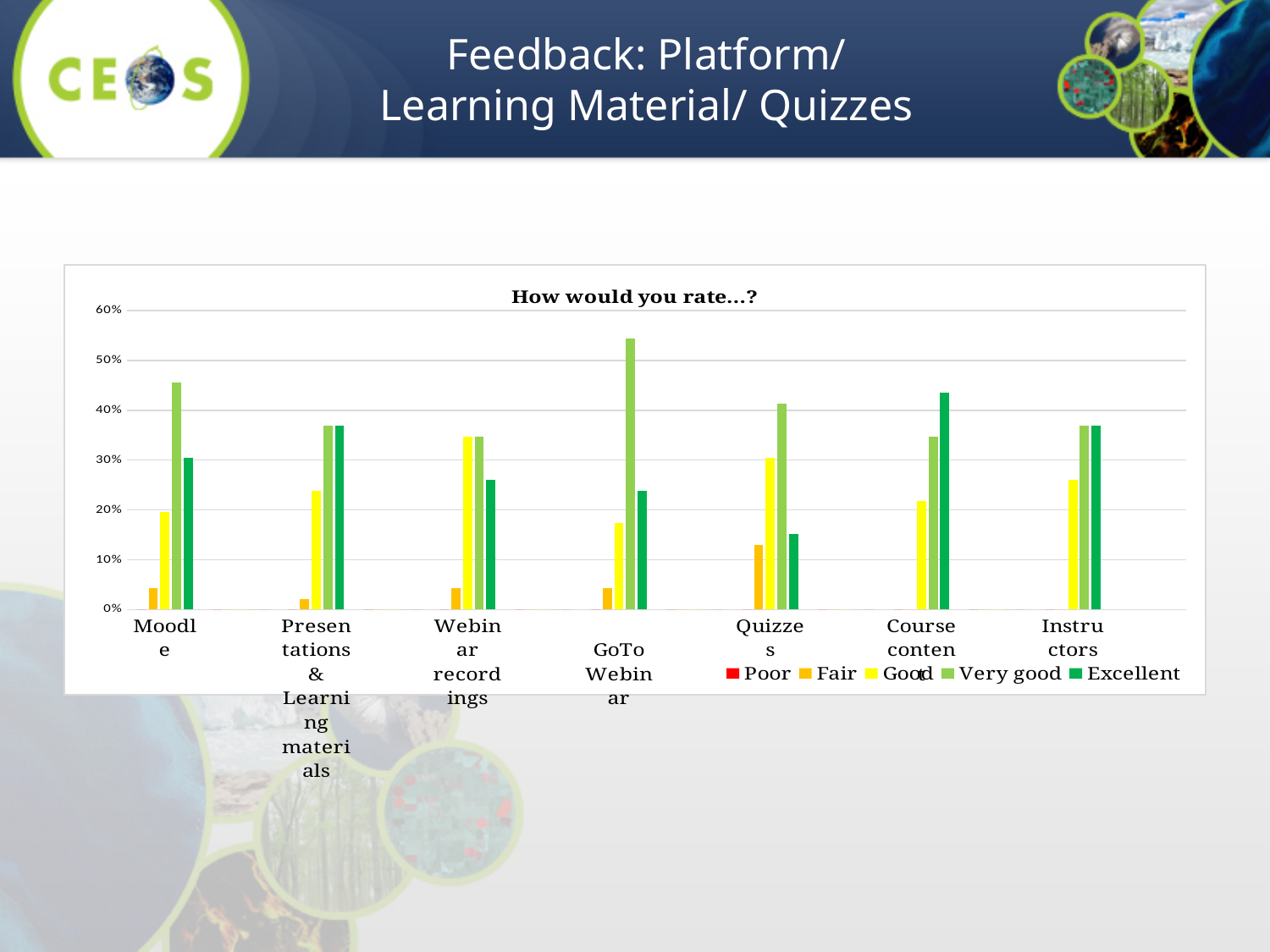
Which category has the highest 'Very good' bar? GoTo Webinar How many series does the legend list? 5 Which category has the lowest 'Excellent' bar? Quizzes How many categories are shown on the x axis? 7 Is the 'Very good' value for Moodle greater or less than 40%? greater For Quizzes, which is larger: the 'Very good' value or the 'Excellent' value? Very good Which series is shown in yellow in the legend? Good What kind of chart is shown on the slide? bar chart Which category has the highest 'Excellent' bar? Course content Is the 'Very good' value for GoTo Webinar greater or less than 50%? greater What is the title of the chart? How would you rate...? Is the 'Fair' value for Quizzes greater or less than 10%? greater